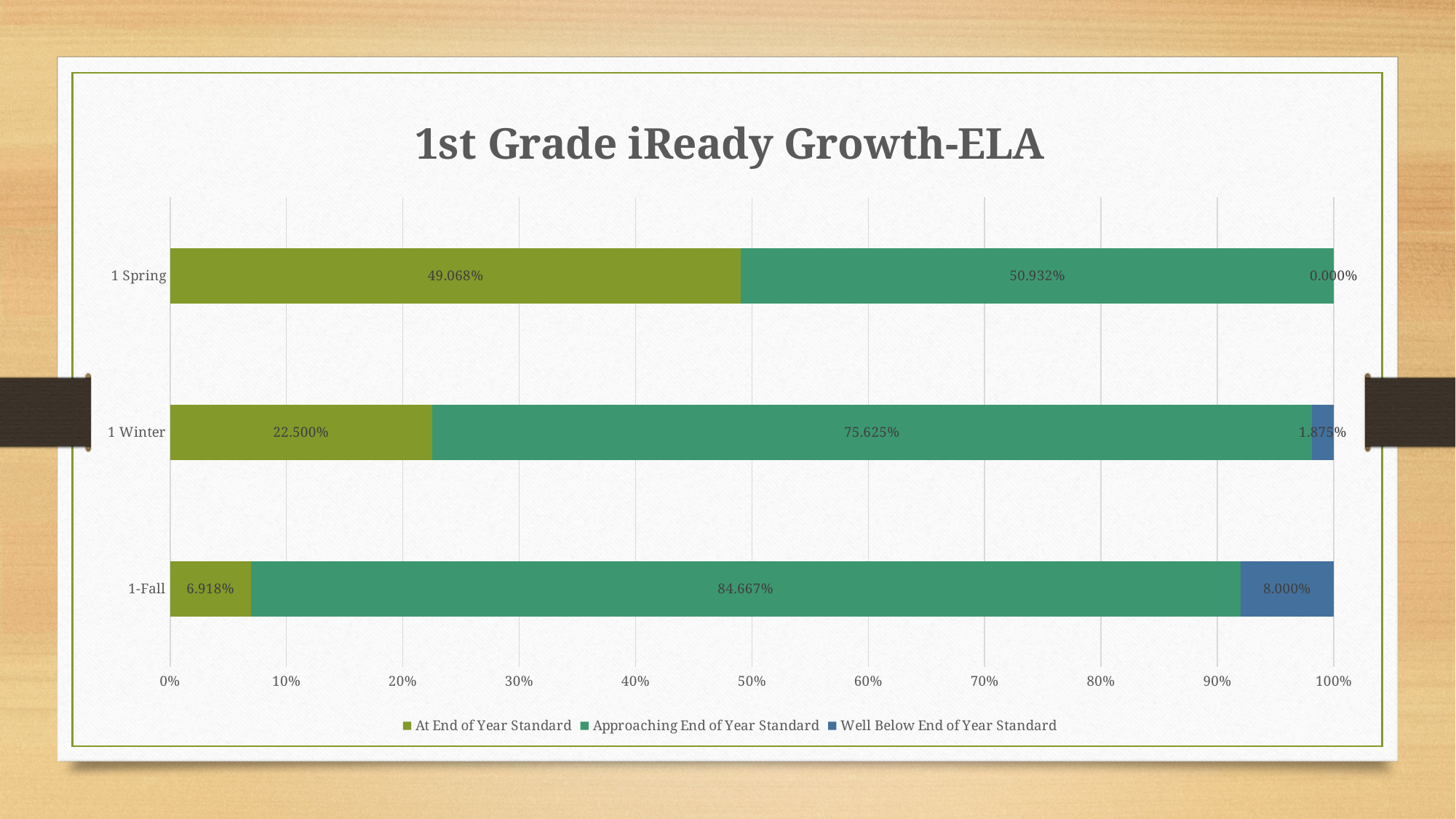
What type of chart is shown on the slide? Stacked bar chart How many series does the legend list? 3 What is the At End of Year Standard value for 1 Spring? 49.068% Which category has the lowest Well Below End of Year Standard value? 1 Spring Does the At End of Year Standard value rise or fall from 1-Fall to 1 Winter to 1 Spring? Rise What is the Approaching End of Year Standard value for 1-Fall? 84.667% Which category has the highest At End of Year Standard value? 1 Spring What is the difference between the Approaching End of Year Standard and At End of Year Standard values for 1 Winter? 53.125% What is the title of the chart? 1st Grade iReady Growth-ELA What is the Well Below End of Year Standard value for 1 Winter? 1.875% How many categories are shown on the chart? 3 Which is larger for 1-Fall: the Well Below End of Year Standard value or the At End of Year Standard value? Well Below End of Year Standard